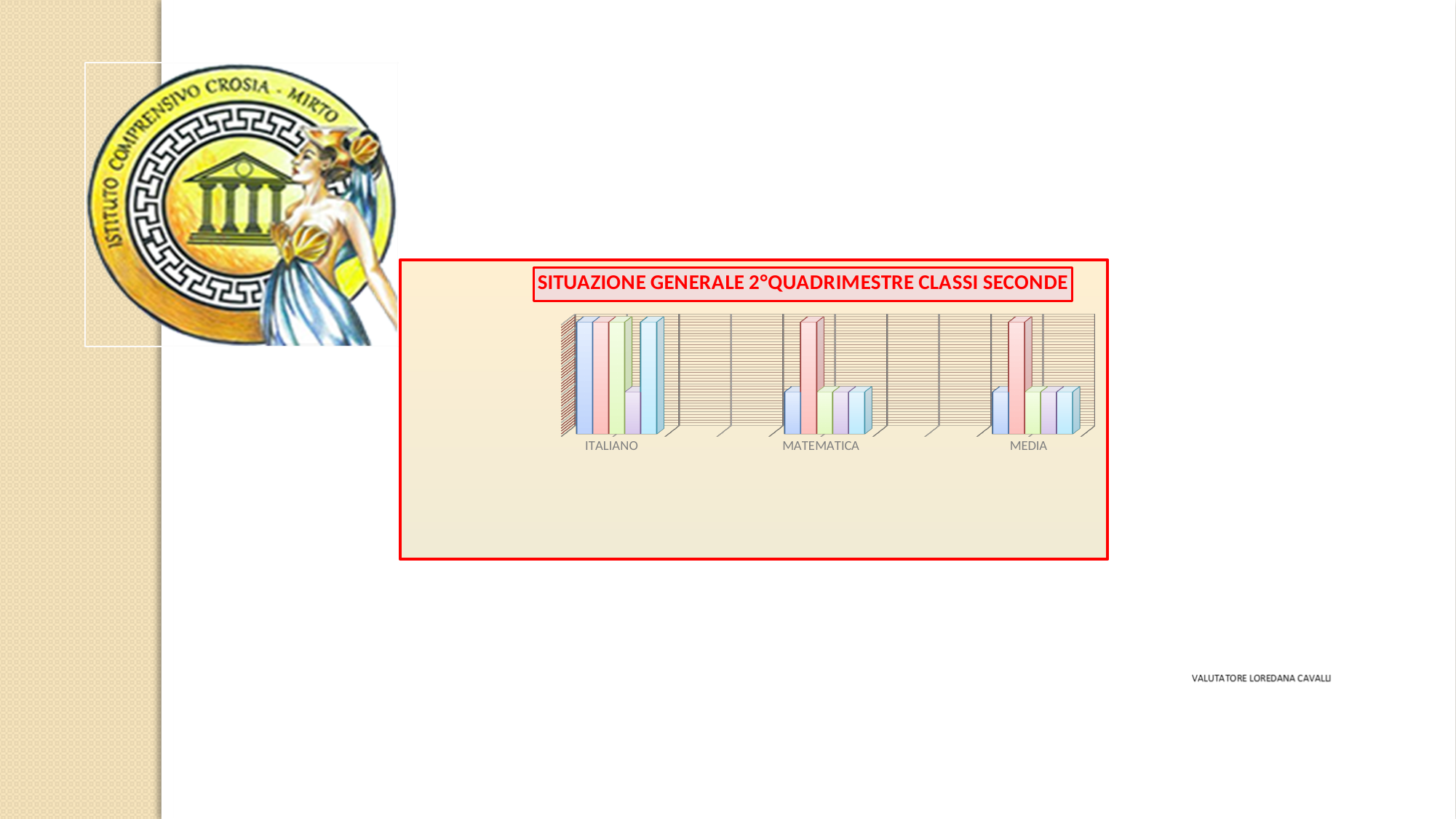
How many bars are plotted for each category in the chart? 5 Which category is shown in the middle of the x axis? MATEMATICA In the MATEMATICA category, is the blue bar taller or shorter than the pink bar? shorter What is the title of the chart? SITUAZIONE GENERALE 2°QUADRIMESTRE CLASSI SECONDE In the MATEMATICA category, which coloured bar is the tallest? the pink bar How many categories are shown on the x axis of the chart? 3 In the ITALIANO category, is the pink bar taller or shorter than the purple bar? taller What kind of chart is shown on the slide? bar chart In the ITALIANO category, which coloured bar is the shortest? the purple bar In the MEDIA category, which coloured bar is the tallest? the pink bar